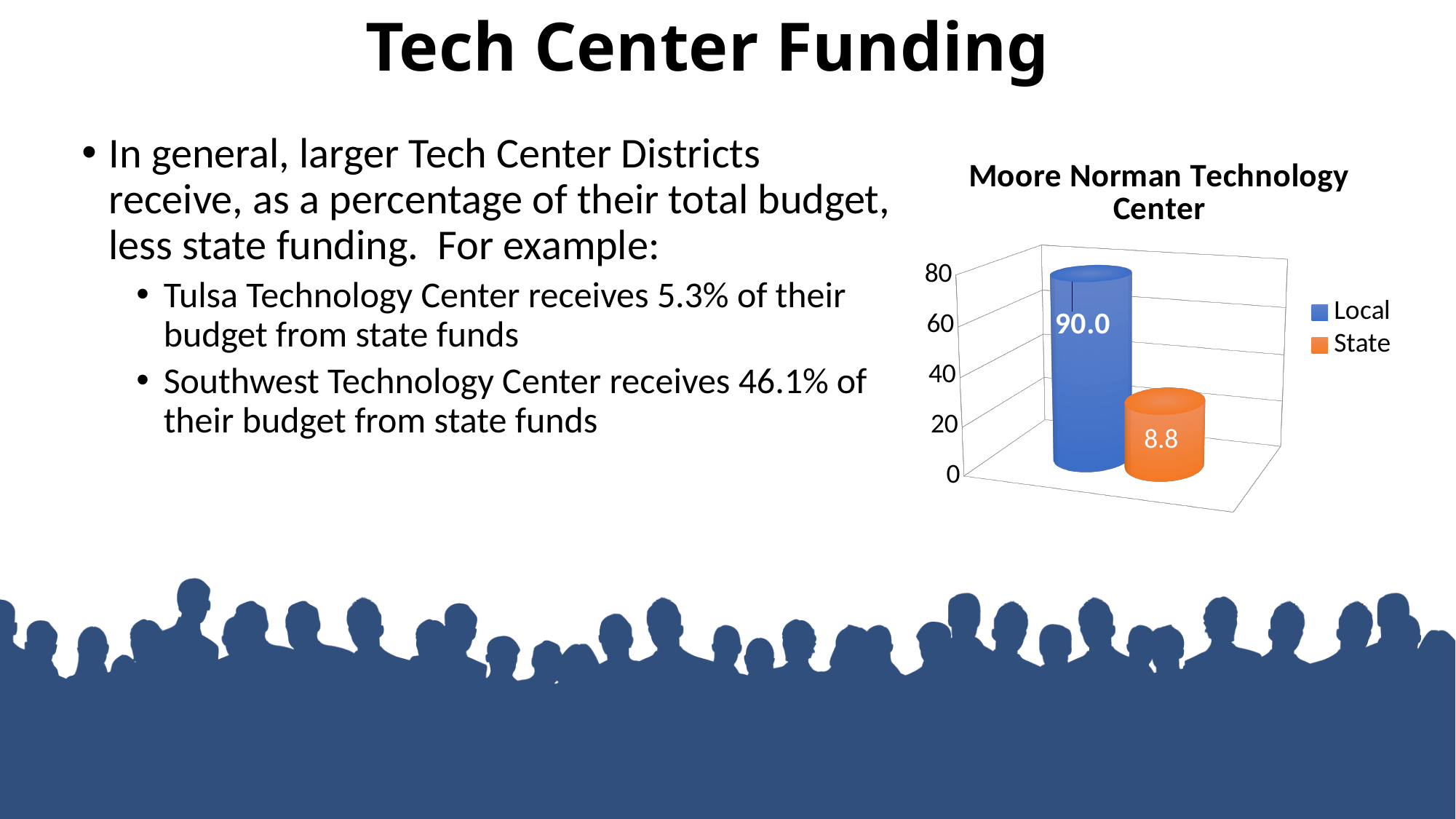
What kind of chart is shown on the slide? bar chart Which is larger in the Moore Norman Technology Center chart, Local or State? Local What is the value for State in the Moore Norman Technology Center chart? 8.8 Which series has the lowest value in the Moore Norman Technology Center chart? State How many series does the legend list in the Moore Norman Technology Center chart? 2 Is the value for Local in the Moore Norman Technology Center chart greater or less than 80? greater What colour is the State bar in the Moore Norman Technology Center chart? orange What is the value for Local in the Moore Norman Technology Center chart? 90.0 What is the difference between the Local and State values in the Moore Norman Technology Center chart? 81.2 Which series has the highest value in the Moore Norman Technology Center chart? Local Is the value for State in the Moore Norman Technology Center chart greater or less than 20? less What is the title of the chart on the slide? Moore Norman Technology Center